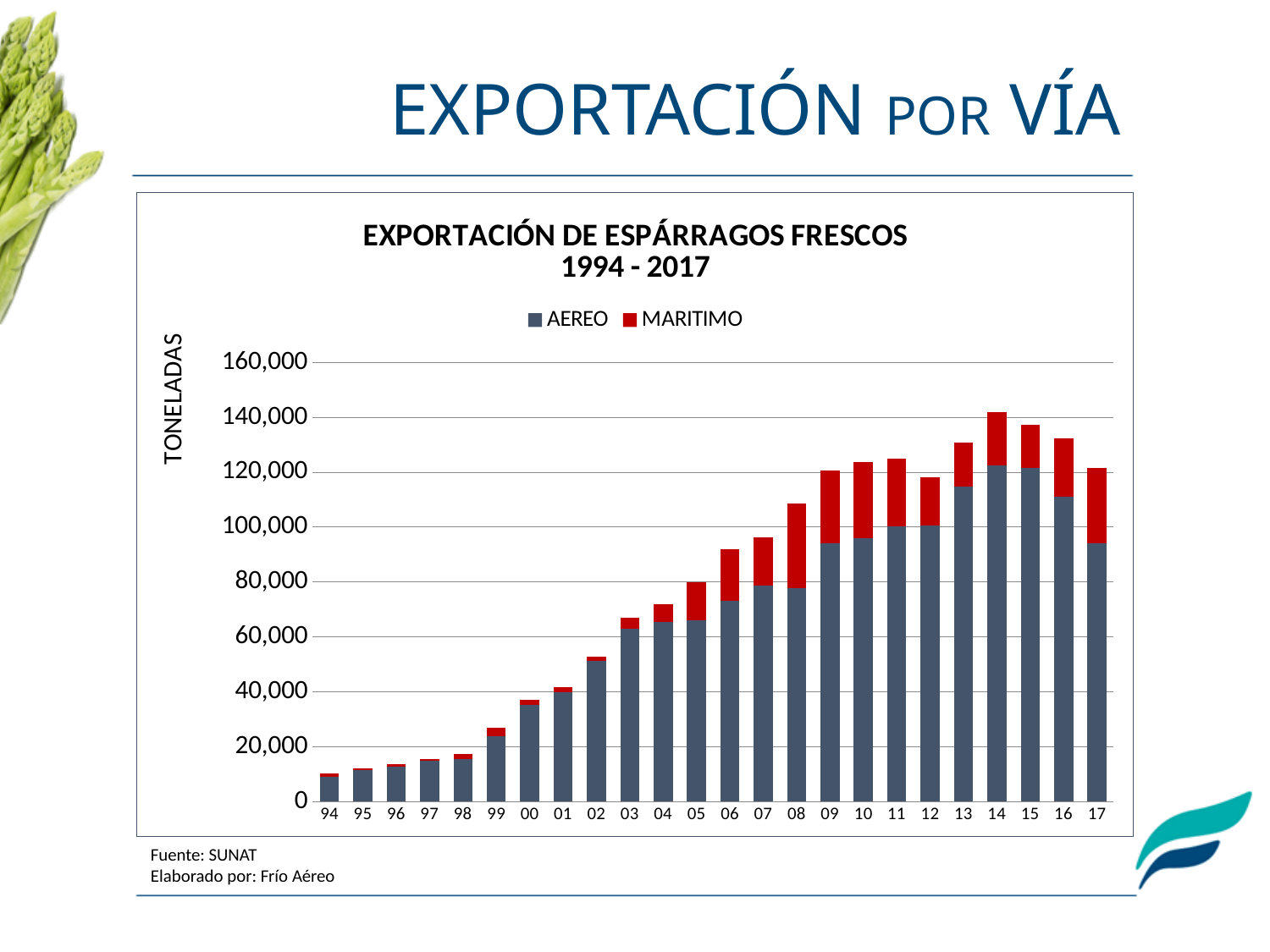
Which year has the tallest total bar? 14 How many series does the legend list? 2 Which year has the larger total bar, 16 or 17? 16 How many years are plotted along the x axis? 24 Which year has the shortest total bar? 94 Do the total values generally rise or fall from 94 to 14? rise Is the total value for 02 greater or less than 60,000? less Is the AEREO value for 17 greater or less than 100,000? less Is the total value for 08 greater or less than 100,000? greater Which series is shown in red? MARITIMO What kind of chart is shown on the slide? Stacked bar chart